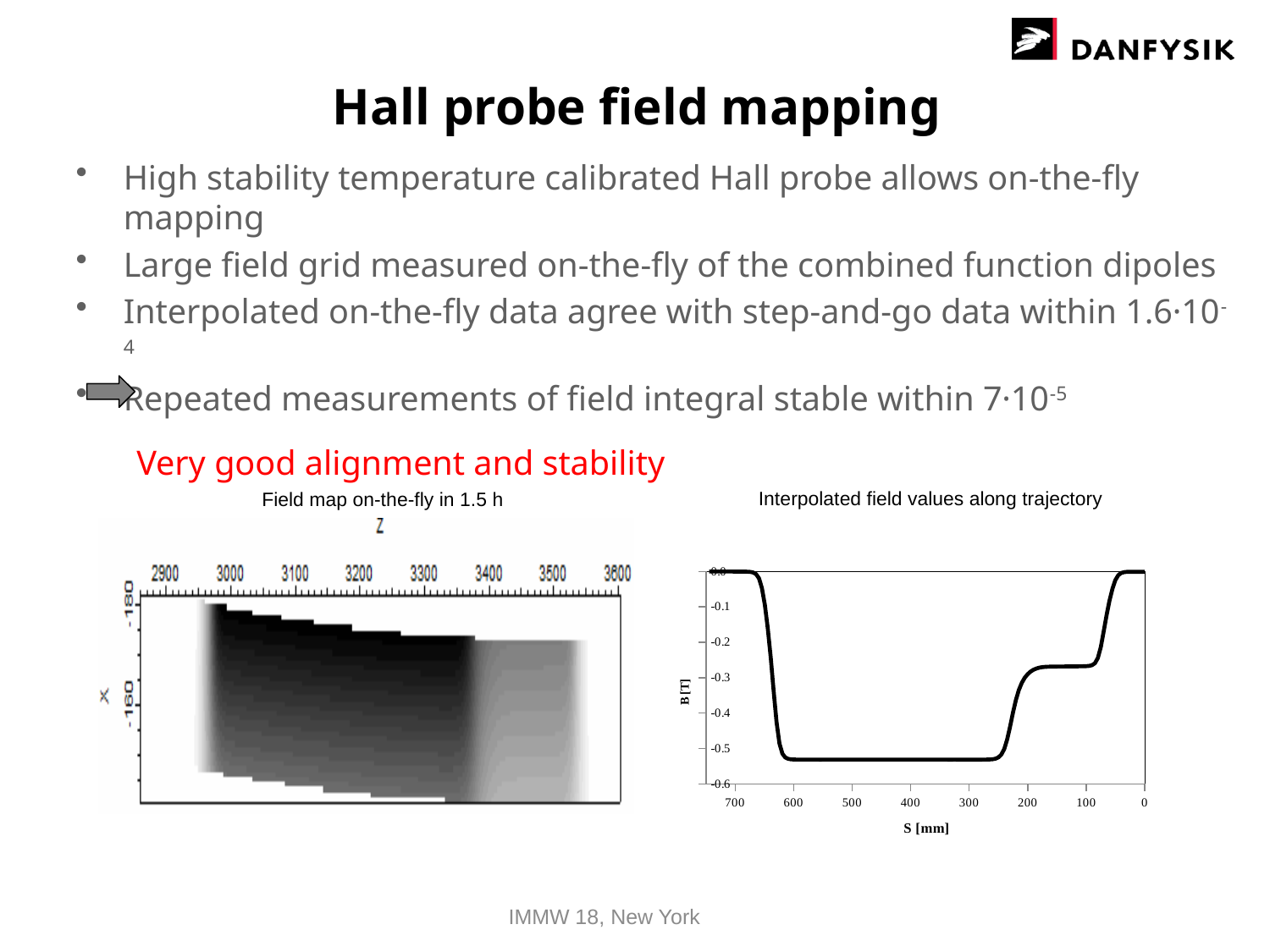
In the 'Interpolated field values along trajectory' chart, is the value of B at S = 400 mm greater or less than -0.4? less In the 'Interpolated field values along trajectory' chart, which is larger, the value of B at S = 400 mm or at S = 150 mm? S = 150 mm In the 'Interpolated field values along trajectory' chart, is the value of B at S = 0 mm greater or less than -0.1? greater In the 'Interpolated field values along trajectory' chart, what is the label of the y axis? B [T] In the 'Interpolated field values along trajectory' chart, does B rise or fall as S goes from 700 mm to 600 mm? fall In the 'Interpolated field values along trajectory' chart, what is the value of B at S = 700 mm? 0.0 In the 'Interpolated field values along trajectory' chart, does B rise or fall as S goes from 250 mm to 0 mm? rise In the 'Interpolated field values along trajectory' chart, what is the label of the x axis? S [mm] What kind of chart is the 'Interpolated field values along trajectory' chart? line chart In the 'Interpolated field values along trajectory' chart, is the value of B at S = 150 mm greater or less than -0.4? greater